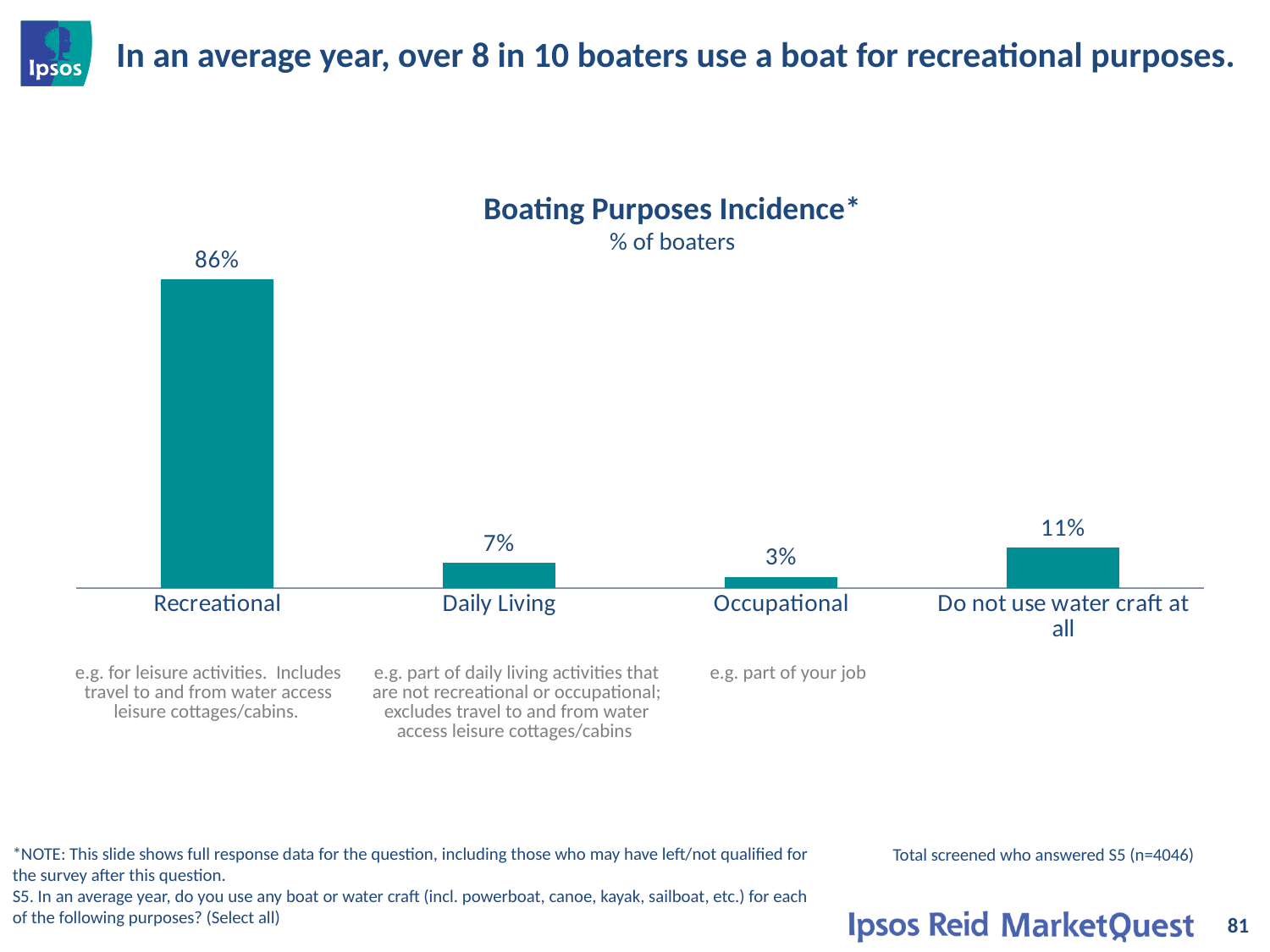
What is the difference between the 'Do not use water craft at all' and Occupational values? 8 percentage points What percentage of boaters use a boat for Recreational purposes? 86% What is the value shown for Daily Living? 7% What is the difference between the Recreational and Daily Living values? 79 percentage points Which category has the lowest value? Occupational Which is larger, Daily Living or 'Do not use water craft at all'? Do not use water craft at all What is the title of the chart? Boating Purposes Incidence* How many categories are shown in the chart? 4 What percentage of boaters do not use water craft at all? 11% Which category has the highest value? Recreational What is the value shown for Occupational? 3% What type of chart is shown on the slide? Bar chart